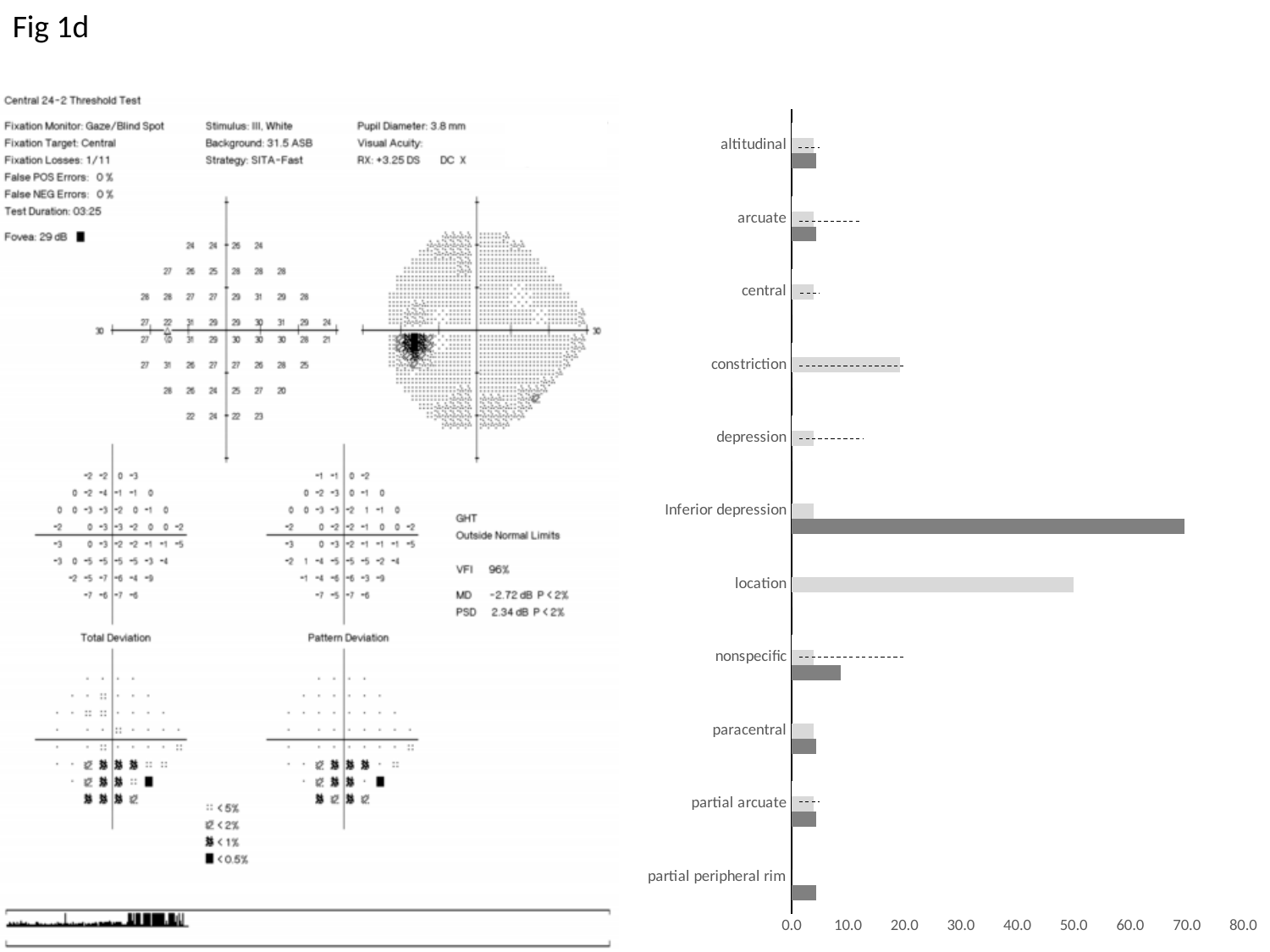
In the bar chart, is the light grey bar for location greater or less than 40.0? greater What kind of chart is shown on the right side of the slide? bar chart In the bar chart, is the light grey bar for constriction greater or less than 30.0? less In the bar chart, is the dark grey bar for Inferior depression greater or less than 60.0? greater In the bar chart, which category has the longest bar? Inferior depression Which category is listed at the top of the bar chart? altitudinal In the bar chart, which has the longer bar: Inferior depression or location? Inferior depression In the bar chart, which has the longer light grey bar: constriction or nonspecific? constriction How many categories are listed on the vertical axis of the bar chart? 11 What is the highest tick value shown on the horizontal axis of the bar chart? 80.0